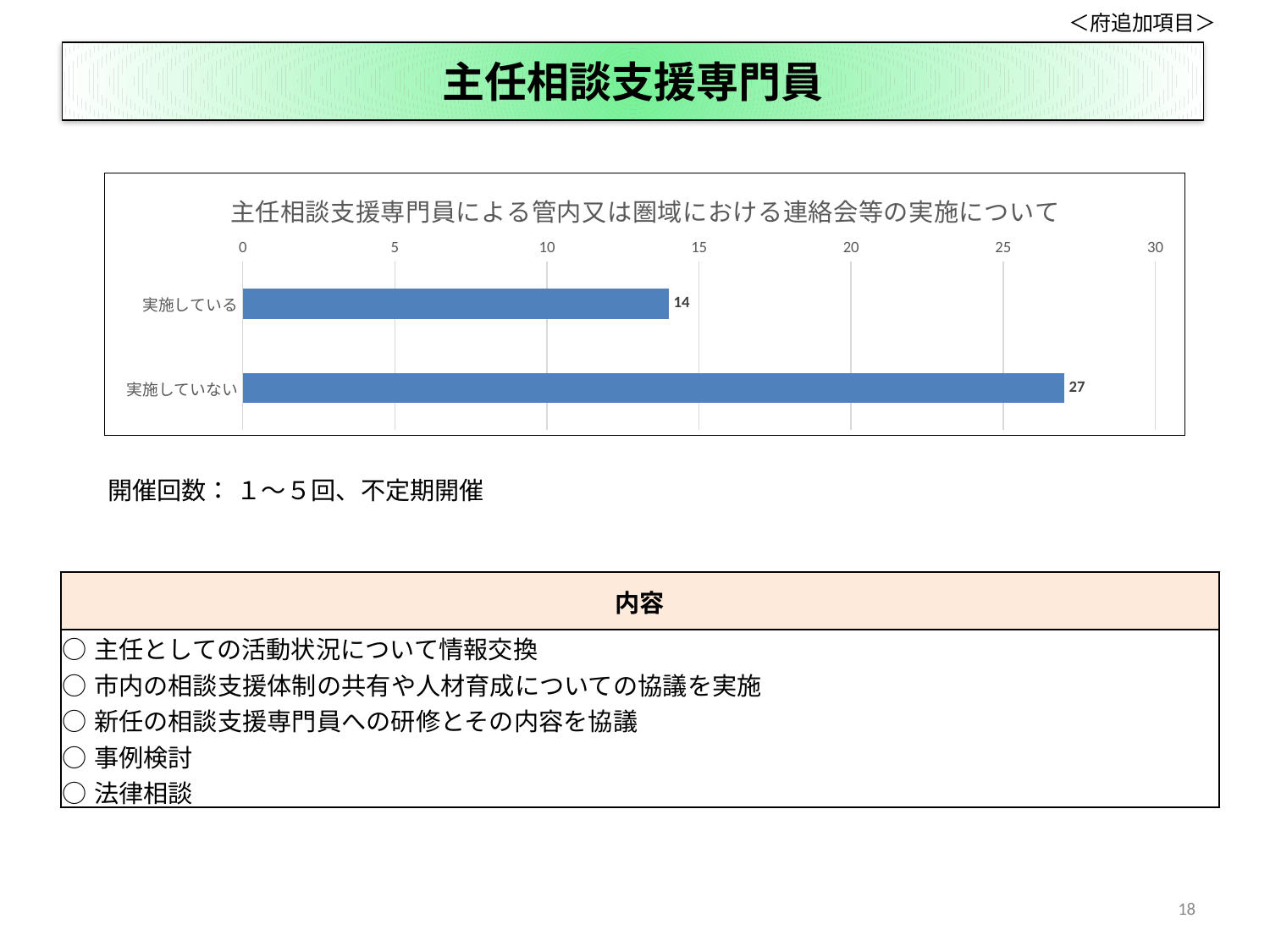
Which category has the highest value? 実施していない Is the value for 実施している greater or less than 15? less What is the title of the chart? 主任相談支援専門員による管内又は圏域における連絡会等の実施について What is the maximum value shown on the chart's axis? 30 Is the value for 実施していない greater or less than 25? greater How many categories are shown in the chart? 2 What is the value for 実施している? 14 What is the value for 実施していない? 27 What is the difference between the values for 実施していない and 実施している? 13 Which is larger, the value for 実施している or the value for 実施していない? 実施していない What kind of chart is shown on the slide? bar chart Which category has the lowest value? 実施している